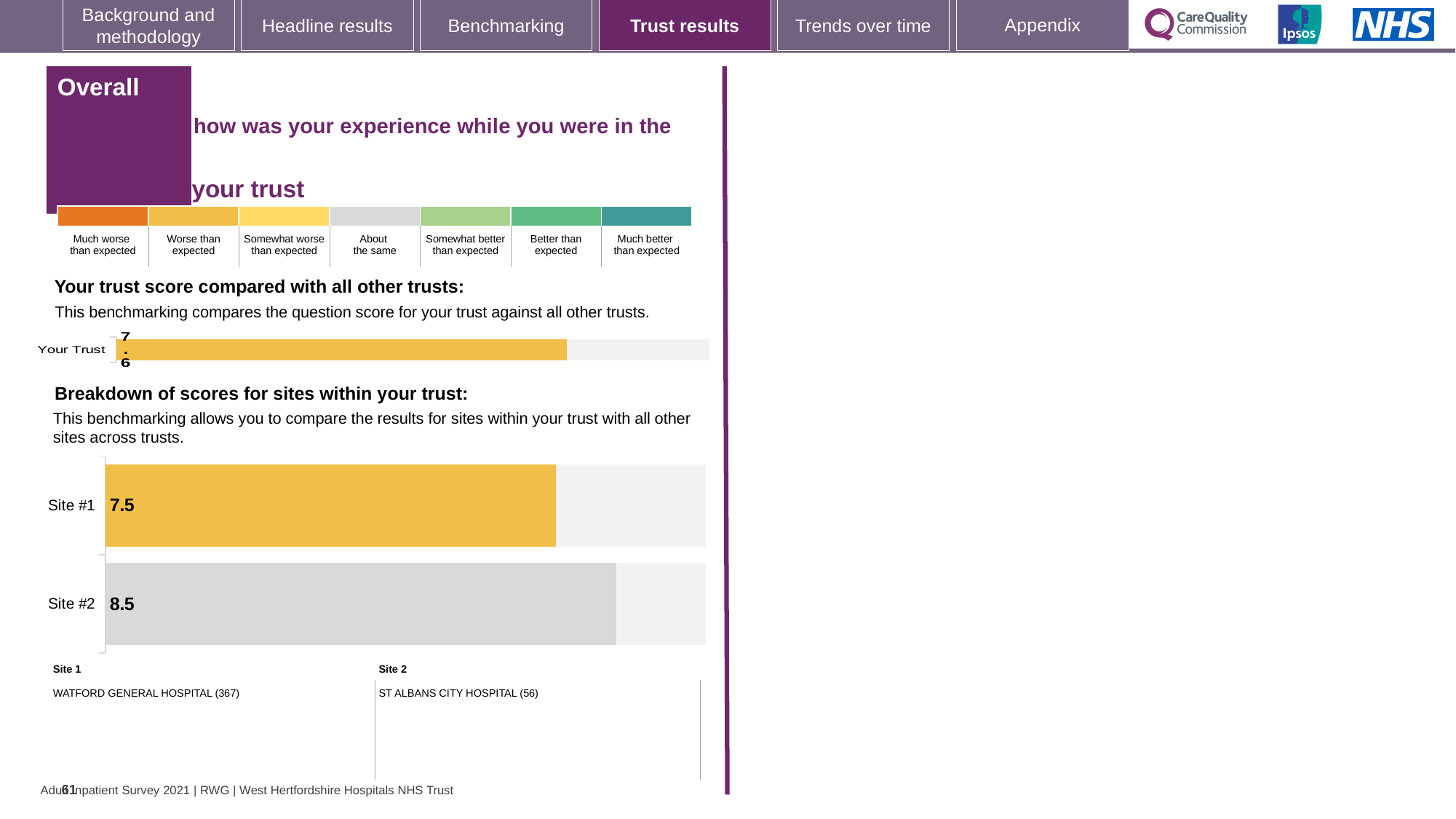
How many sites are shown in the 'Breakdown of scores for sites within your trust' chart? 2 In the 'Breakdown of scores for sites within your trust' chart, which site has the lowest score? Site #1 In the 'Breakdown of scores for sites within your trust' chart, which hospital is Site 2? ST ALBANS CITY HOSPITAL (56) In the 'Breakdown of scores for sites within your trust' chart, what is the score for Site #1? 7.5 In the 'Breakdown of scores for sites within your trust' chart, what is the score for Site #2? 8.5 In the 'Breakdown of scores for sites within your trust' chart, which site has the highest score? Site #2 What kind of chart is the 'Breakdown of scores for sites within your trust' chart? Bar chart In the 'Breakdown of scores for sites within your trust' chart, which hospital is Site 1? WATFORD GENERAL HOSPITAL (367) In the 'Breakdown of scores for sites within your trust' chart, what is the difference between the scores for Site #2 and Site #1? 1.0 What kind of chart is the 'Your trust score compared with all other trusts' chart? Bar chart In the 'Your trust score compared with all other trusts' chart, what is the score for Your Trust? 7.6 In the 'Breakdown of scores for sites within your trust' chart, which has the larger score, Site #1 or Site #2? Site #2